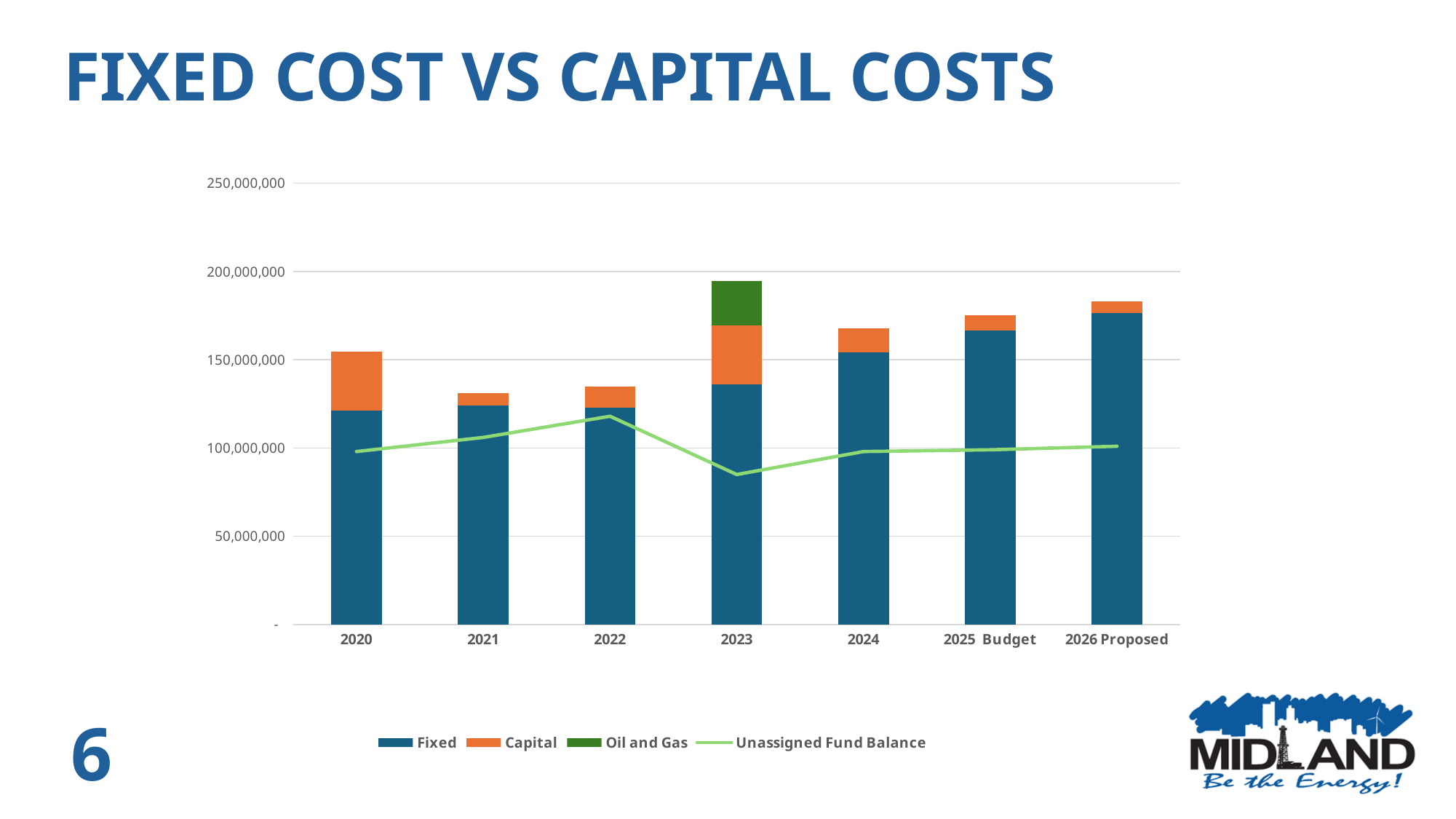
How many categories are shown on the x axis? 7 Is the Unassigned Fund Balance for 2022 greater or less than 100,000,000? greater What kind of chart is shown on the slide? bar chart with a line Does the Fixed value rise or fall from 2023 to 2026 Proposed? rise How many series does the legend list? 4 Is the Fixed value for 2020 greater or less than 150,000,000? less Is the Unassigned Fund Balance for 2023 greater or less than 100,000,000? less Which is larger, the Fixed value for 2024 or the Fixed value for 2021? 2024 Which category has the highest Fixed value? 2026 Proposed Which category is the only one with an Oil and Gas segment? 2023 Which category has the tallest stacked bar overall? 2023